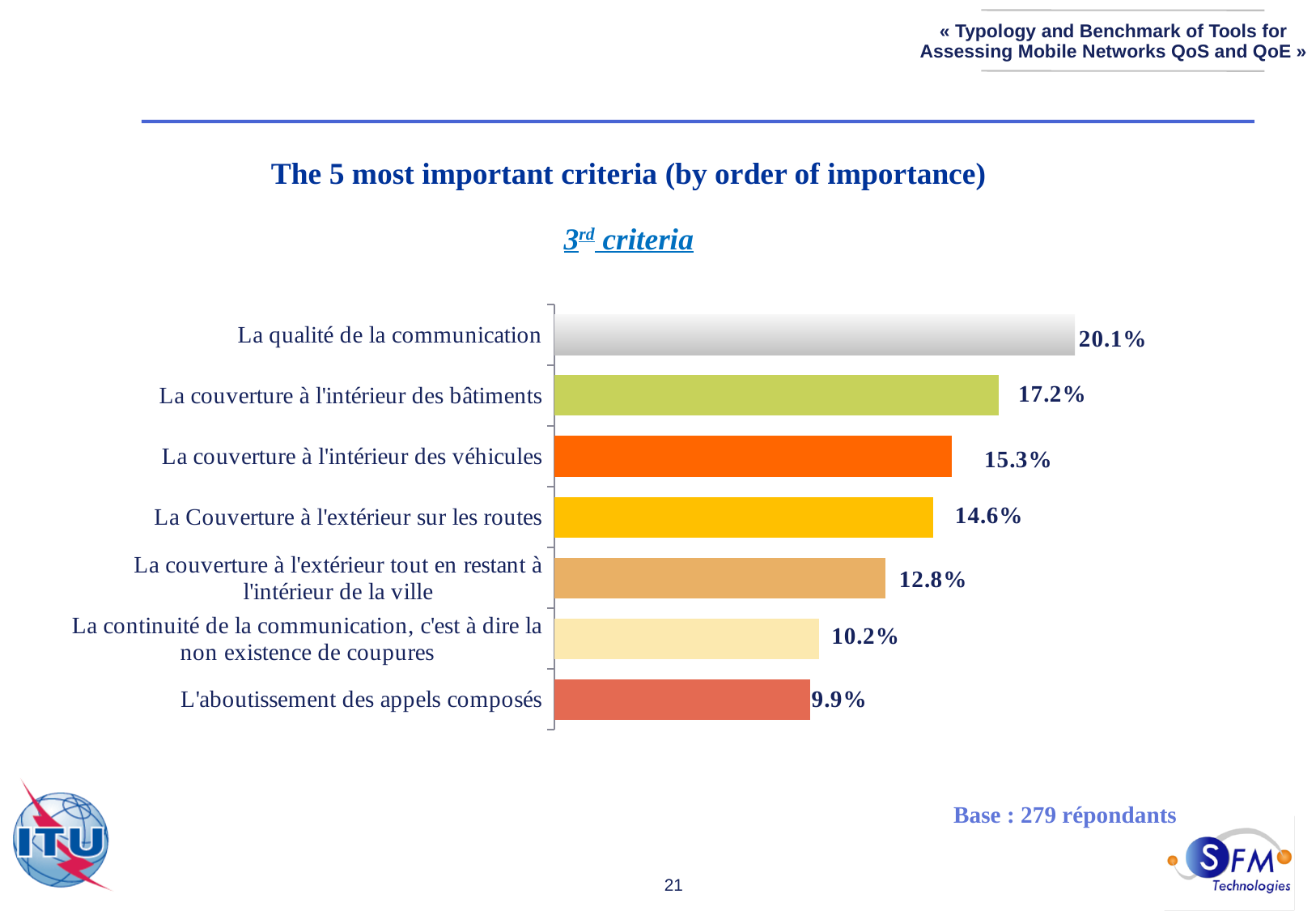
What is the value for "L'aboutissement des appels composés"? 9.9% What is the difference between the values for "La Couverture à l'extérieur sur les routes" and "La continuité de la communication, c'est à dire la non existence de coupures"? 4.4% What is the value for "La couverture à l'extérieur tout en restant à l'intérieur de la ville"? 12.8% What is the value for "La couverture à l'intérieur des véhicules"? 15.3% What is the base (number of respondents) stated on the slide? 279 répondants Which is larger: the value for "La couverture à l'intérieur des bâtiments" or the value for "La Couverture à l'extérieur sur les routes"? La couverture à l'intérieur des bâtiments What kind of chart is shown on the slide? Bar chart What is the difference between the values for "La qualité de la communication" and "La couverture à l'intérieur des bâtiments"? 2.9% What is the value for "La qualité de la communication"? 20.1% How many categories are shown in the chart? 7 Which category has the lowest value? L'aboutissement des appels composés Which category has the highest value? La qualité de la communication